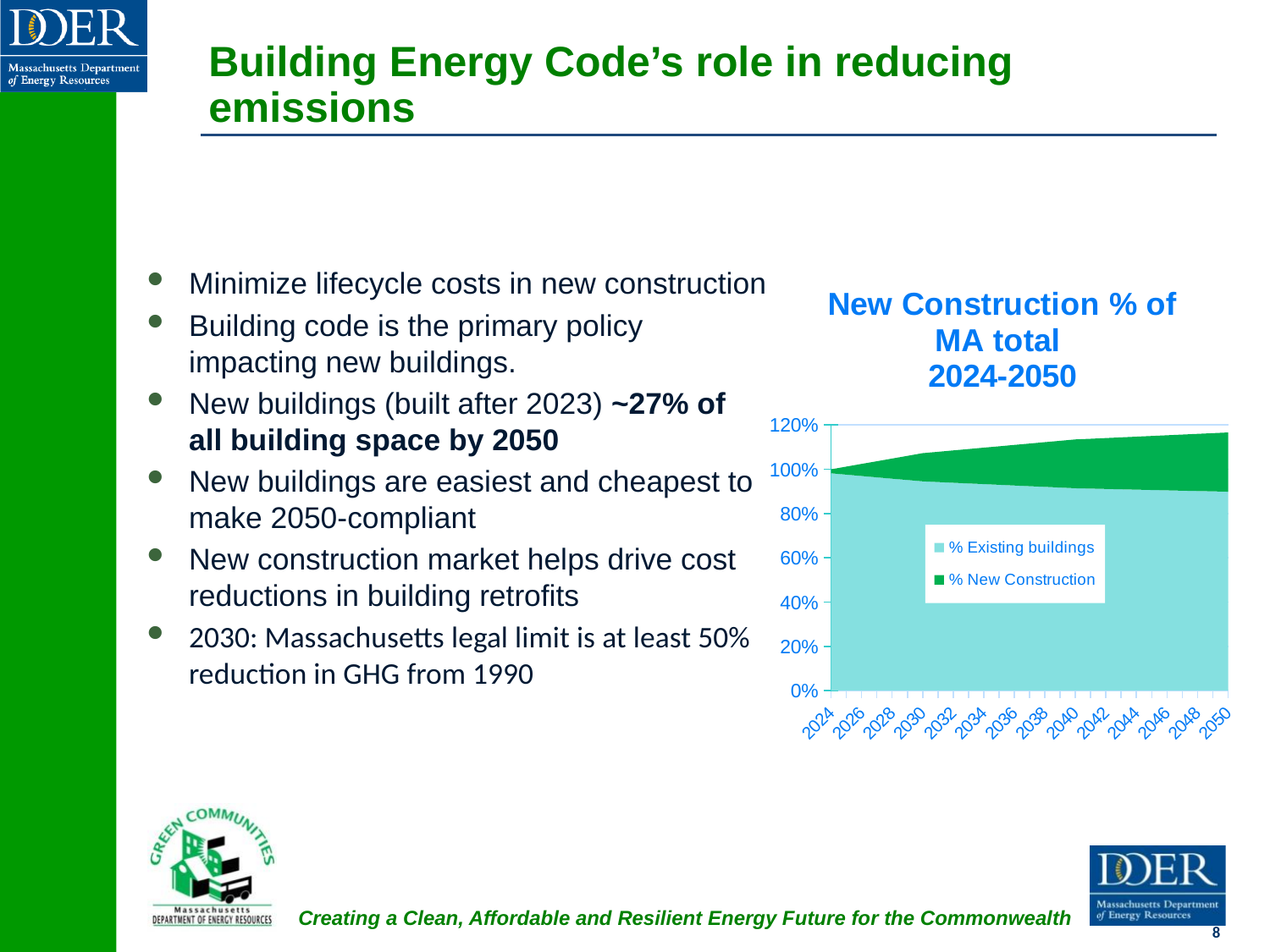
Does the % New Construction series rise or fall from 2024 to 2050? Rise What kind of chart is shown on the slide? Stacked area chart Is the value for % Existing buildings in 2024 greater or less than 80%? greater What is the title of the chart? New Construction % of MA total 2024-2050 What is the highest value shown on the y axis of the chart? 120% How many series does the chart legend list? 2 What is the first year shown on the x axis of the chart? 2024 Does the % Existing buildings series rise or fall from 2024 to 2050? Fall How many year labels are shown on the x axis of the chart? 14 Is the value for % Existing buildings in 2050 greater or less than 60%? greater Which series is shown in dark green in the chart? % New Construction In 2050, which series has the larger value: % Existing buildings or % New Construction? % Existing buildings